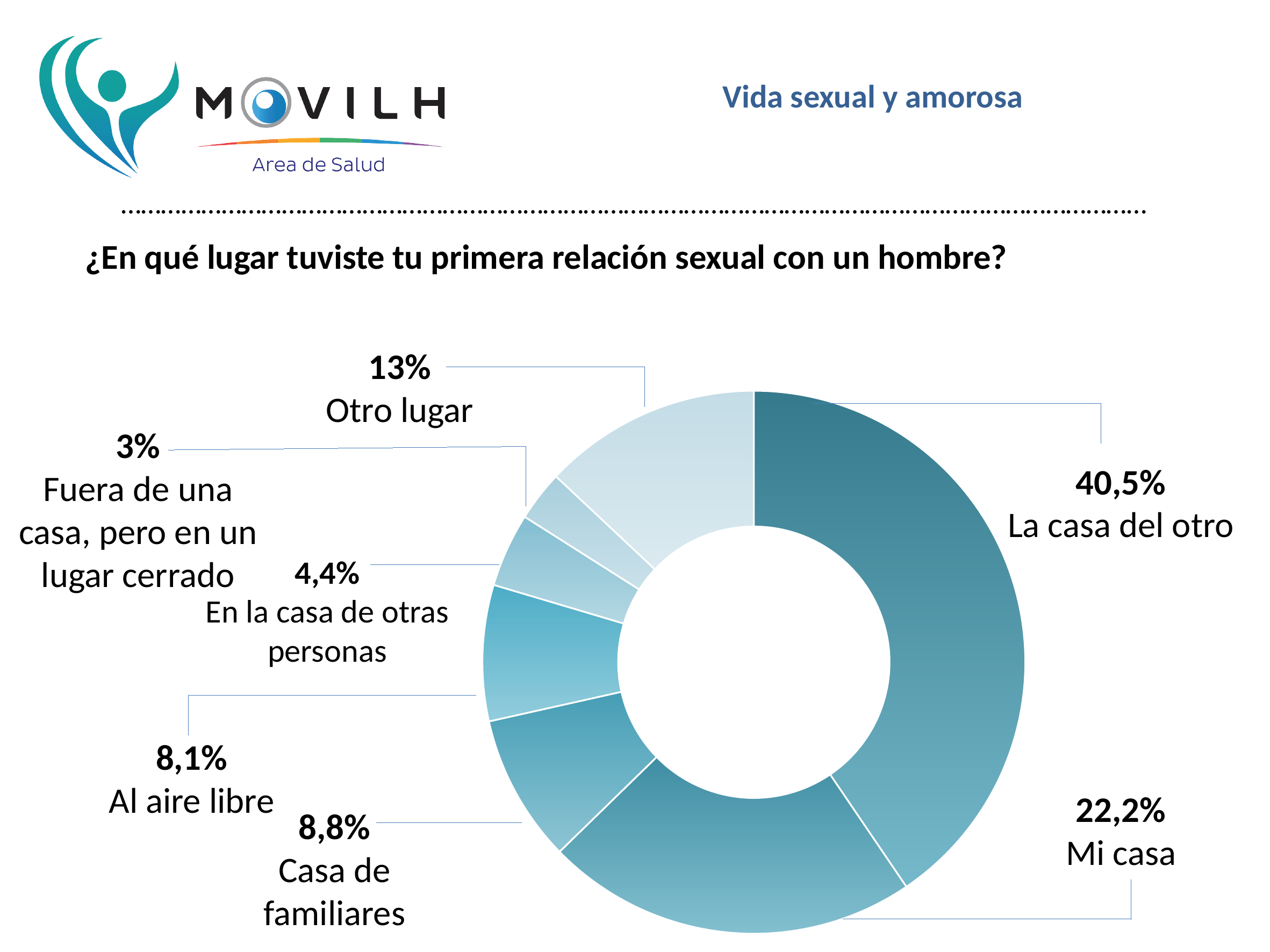
What percentage is shown for "Otro lugar"? 13% Which has a larger share, "Casa de familiares" or "Otro lugar"? Otro lugar What kind of chart is shown on the slide? Doughnut chart What is the difference in percentage points between "La casa del otro" and "Mi casa"? 18,3% What percentage is shown for "Al aire libre"? 8,1% How many categories are shown in the chart? 7 What percentage is shown for "En la casa de otras personas"? 4,4% Which category has the largest share of the chart? La casa del otro What is the difference in percentage points between "Otro lugar" and "Fuera de una casa, pero en un lugar cerrado"? 10% What percentage is shown for "La casa del otro"? 40,5% Which category has the smallest share of the chart? Fuera de una casa, pero en un lugar cerrado What percentage is shown for "Mi casa"? 22,2%